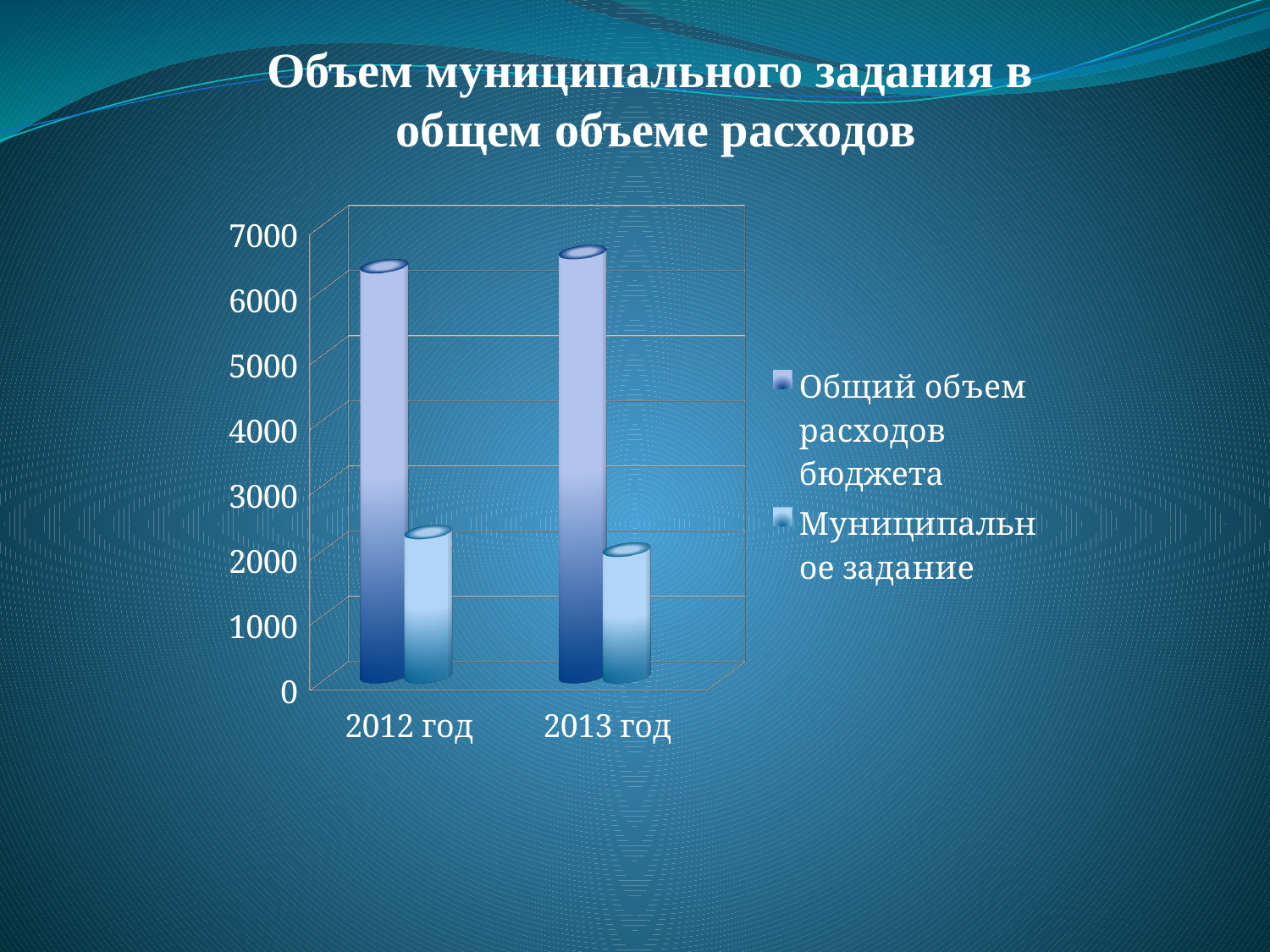
Is the value for Муниципальное задание in 2013 год greater or less than 3000? less How many categories are shown on the x axis? 2 How many series does the legend list? 2 Is the value for Общий объем расходов бюджета in 2013 год greater or less than 7000? less Which series has the higher value in 2013 год? Общий объем расходов бюджета What kind of chart is shown on the slide? bar chart Is the value for Общий объем расходов бюджета in 2012 год greater or less than 6000? greater What is the title of the chart? Объем муниципального задания в общем объеме расходов What are the two categories on the x axis? 2012 год, 2013 год Which year has the higher value for Муниципальное задание? 2012 год Does the value for Общий объем расходов бюджета rise or fall from 2012 год to 2013 год? rise